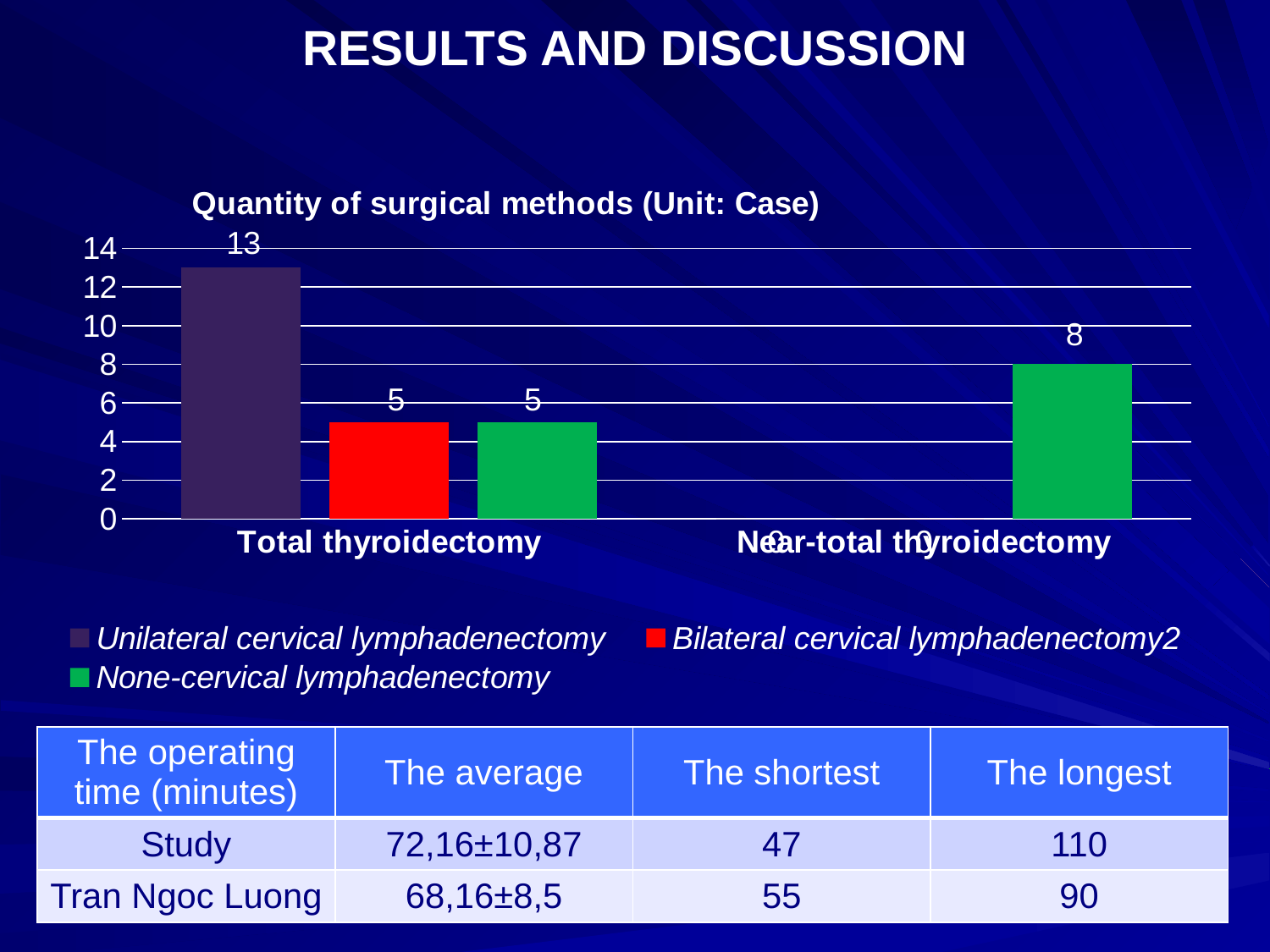
What colour is the bar for None-cervical lymphadenectomy? green What kind of chart is shown on the slide? bar chart What is the value for None-cervical lymphadenectomy in the Near-total thyroidectomy category? 8 What is the title of the chart? Quantity of surgical methods (Unit: Case) What is the value for Bilateral cervical lymphadenectomy2 in the Total thyroidectomy category? 5 How many series does the chart legend list? 3 How many categories are shown on the x axis of the chart? 2 What is the value for None-cervical lymphadenectomy in the Total thyroidectomy category? 5 What is the difference between the Unilateral cervical lymphadenectomy value for Total thyroidectomy and the None-cervical lymphadenectomy value for Near-total thyroidectomy? 5 Which series has the highest value in the Total thyroidectomy category? Unilateral cervical lymphadenectomy Which is larger: the None-cervical lymphadenectomy value for Total thyroidectomy or for Near-total thyroidectomy? Near-total thyroidectomy What is the value for Unilateral cervical lymphadenectomy in the Total thyroidectomy category? 13